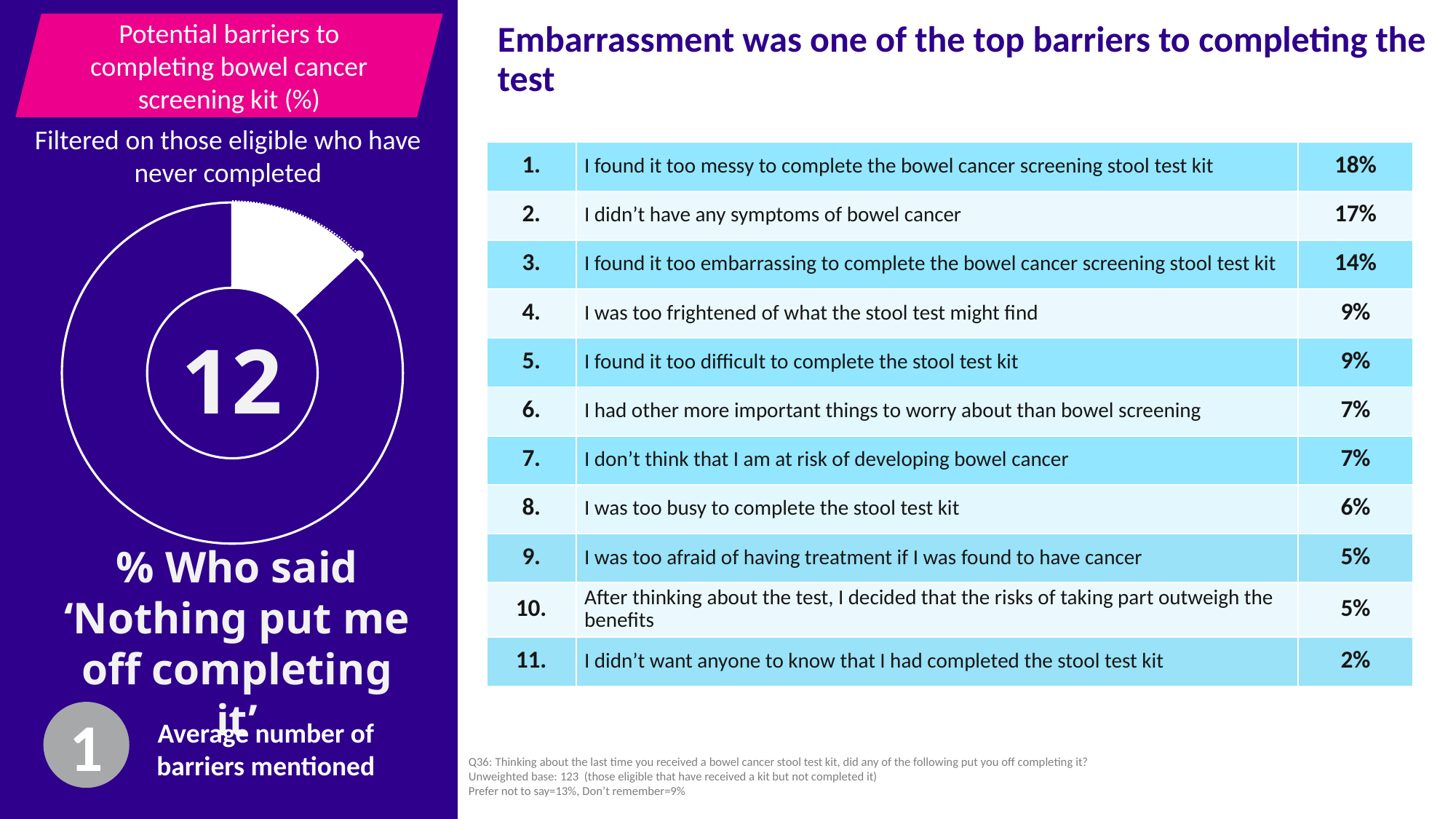
What is the average number of barriers mentioned, as shown in the grey circle at the bottom left? 1 In the table on the right, which is larger: the percentage for 'I was too busy to complete the stool test kit' or 'I was too frightened of what the stool test might find'? I was too frightened of what the stool test might find What does the donut chart on the left of the slide represent, according to the label beneath it? % Who said 'Nothing put me off completing it' What kind of chart is shown on the left of the slide under 'Filtered on those eligible who have never completed'? Donut (pie) chart In the table on the right, what is the difference between the percentage for 'I found it too messy' and 'I didn't have any symptoms of bowel cancer'? 1% In the table on the right, how many barriers are listed? 11 In the table on the right, what percentage said 'I found it too embarrassing to complete the bowel cancer screening stool test kit'? 14% In the table on the right, which barrier has the lowest percentage? I didn't want anyone to know that I had completed the stool test kit What value is shown in the centre of the donut chart on the left of the slide? 12 Is the filled share of the donut chart on the left greater or less than 50%? less In the table on the right, which barrier has the highest percentage? I found it too messy to complete the bowel cancer screening stool test kit